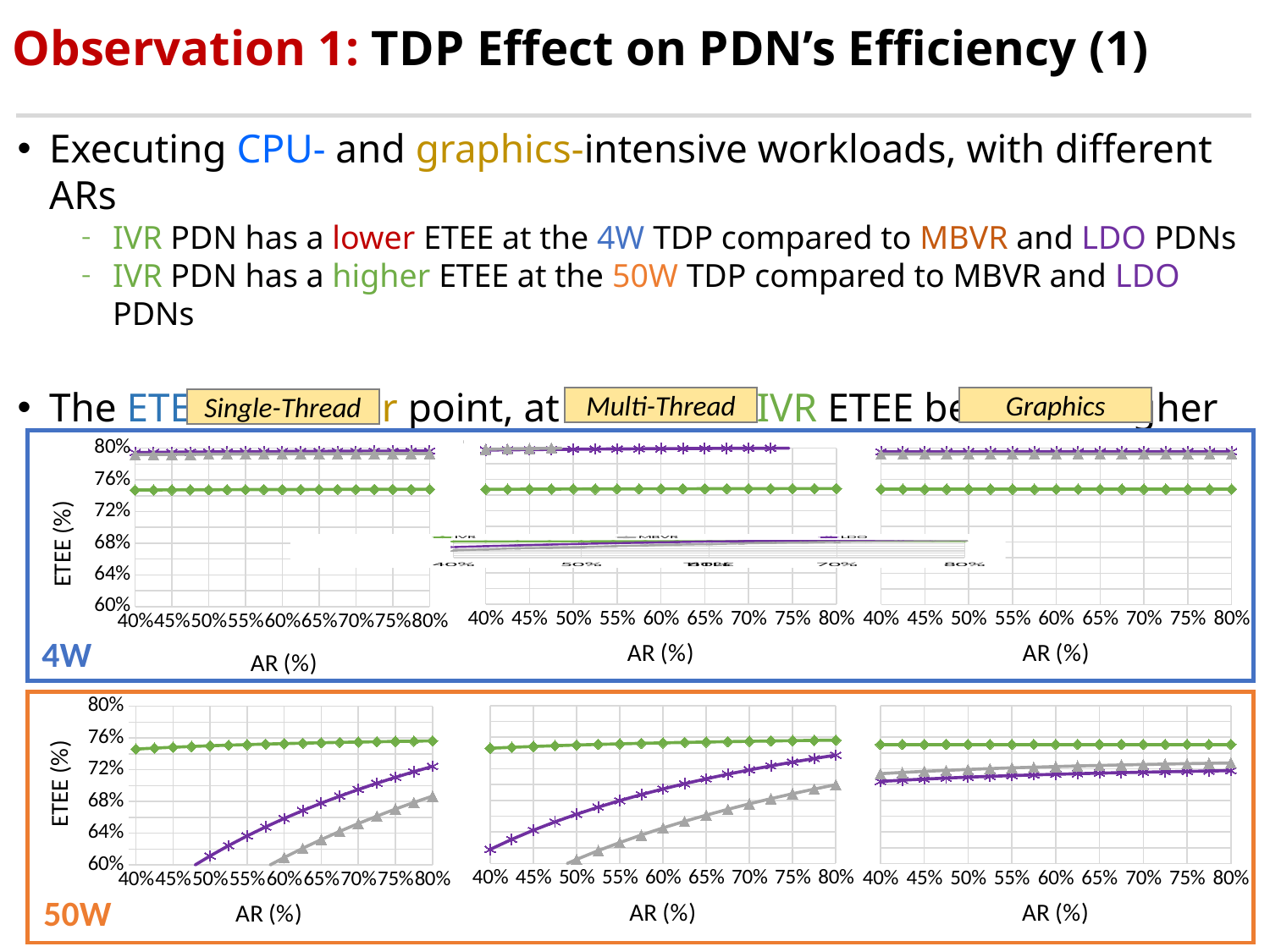
In the 50W Multi-Thread chart, is the LDO value at 40% AR greater or less than 64%? less What kind of chart is the 4W Single-Thread chart? line chart How many series does the legend list for the charts? 3 What is the y-axis label of the 4W charts? ETEE (%) In the 50W Graphics chart, is the IVR value at 80% AR greater or less than 72%? greater In the 50W Single-Thread chart, which series has the highest ETEE? IVR In the 50W Single-Thread chart, does the LDO series rise or fall as AR increases? rises In the 50W Multi-Thread chart, is the MBVR value at 80% AR greater or less than 68%? greater In the 4W Single-Thread chart, which series has the lowest ETEE? IVR In the 50W Single-Thread chart, at 80% AR, which is larger, LDO or MBVR? LDO How many AR tick labels are shown on the x axis of the 50W Graphics chart? 9